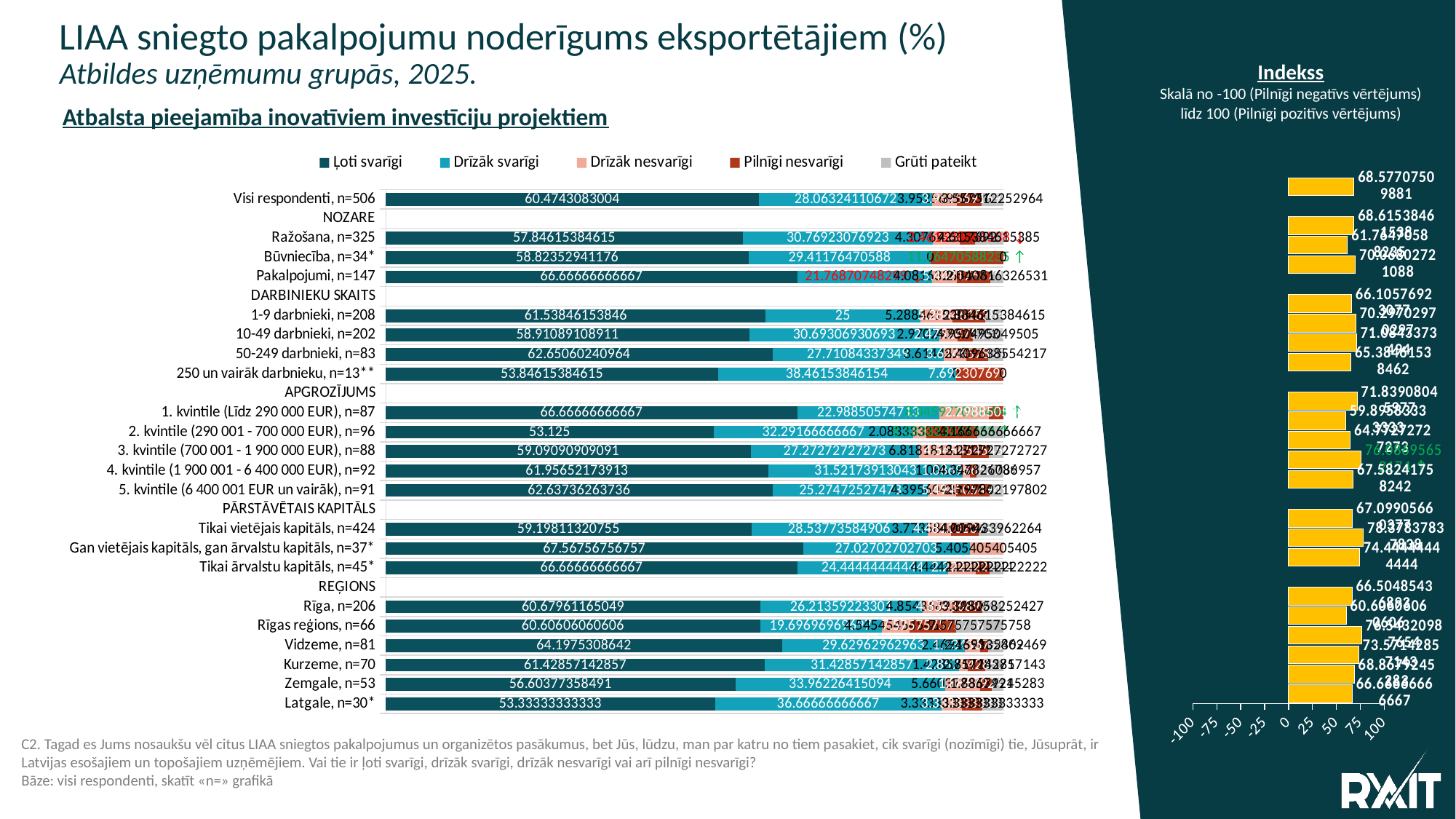
What kind of chart is the chart on the left of the slide? Stacked bar chart In the stacked bar chart, what is the 'Drīzāk svarīgi' value for 250 un vairāk darbinieku, n=13**? 38.46153846154 In the stacked bar chart, what is the 'Drīzāk svarīgi' value for 1-9 darbinieki, n=208? 25 In the stacked bar chart, what is the 'Ļoti svarīgi' value for Latgale, n=30*? 53.33333333333 In the stacked bar chart, what is the difference between the 'Drīzāk svarīgi' values for 250 un vairāk darbinieku, n=13** and 1-9 darbinieki, n=208? 13.46153846154 In the stacked bar chart, what is the 'Ļoti svarīgi' value for Gan vietējais kapitāls, gan ārvalstu kapitāls, n=37*? 67.56756756757 How many series does the legend of the stacked bar chart list? 5 How many respondent groups (bars) are plotted in the stacked bar chart? 22 In the stacked bar chart, which has the larger 'Drīzāk svarīgi' value: Rīgas reģions, n=66 or Zemgale, n=53? Zemgale, n=53 In the stacked bar chart, which has the larger 'Ļoti svarīgi' value: Pakalpojumi, n=147 or Ražošana, n=325? Pakalpojumi, n=147 In the Indekss chart on the right, what is the index value for Visi respondenti, n=506 (the top bar)? 68.57707509881 In the stacked bar chart, what is the 'Ļoti svarīgi' value for Visi respondenti, n=506? 60.4743083004